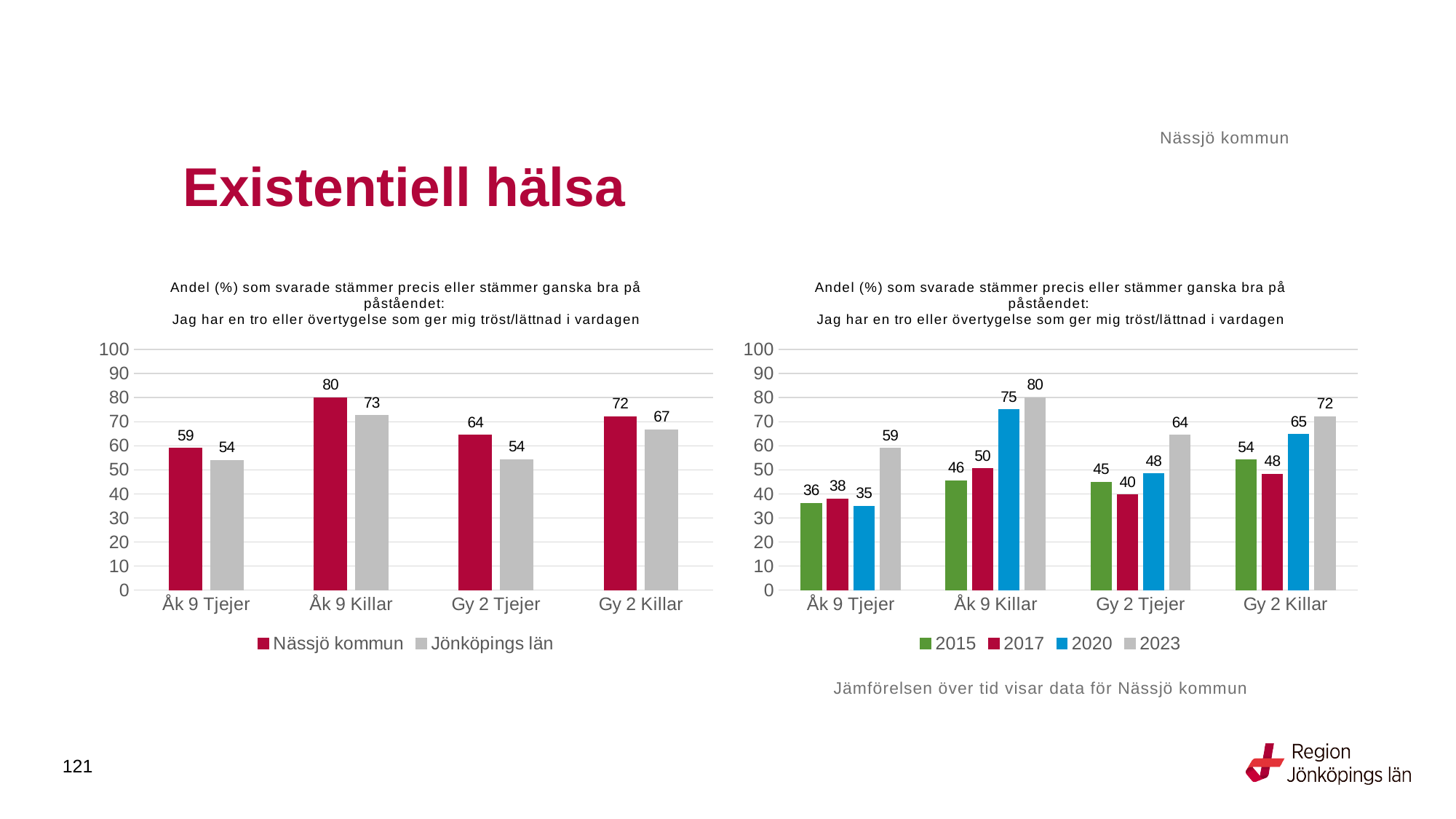
In the right chart, which is larger for Gy 2 Tjejer: the 2017 value or the 2020 value? 2020 In the right chart, how many series does the legend list? 4 In the left chart, what is the value for Jönköpings län for Gy 2 Tjejer? 54 In the left chart, what is the value for Nässjö kommun for Åk 9 Killar? 80 In the right chart, what is the difference between the 2023 and 2015 values for Åk 9 Killar? 34 In the right chart, what is the value for 2020 for Åk 9 Killar? 75 In the left chart, how many series does the legend list? 2 In the left chart, what is the difference between Nässjö kommun and Jönköpings län for Gy 2 Tjejer? 10 In the left chart, which category has the highest value for Jönköpings län? Åk 9 Killar In the right chart, what is the value for 2015 for Gy 2 Killar? 54 What kind of chart is the right chart? Bar chart In the right chart, which category has the lowest value for 2020? Åk 9 Tjejer